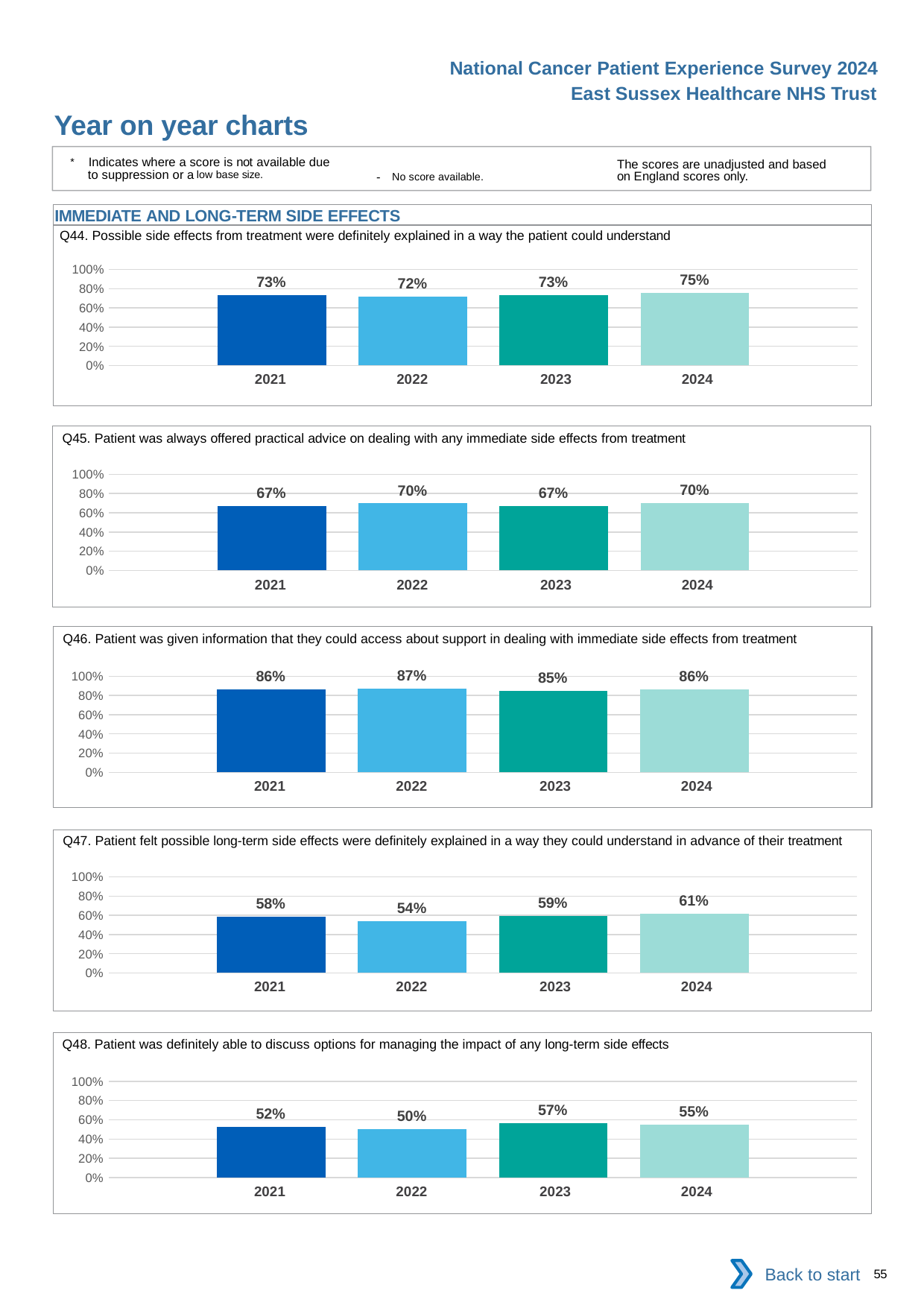
What kind of chart is the Q46 chart? bar chart How many years are shown in the Q44 chart? 4 In the Q45 chart, what is the value for 2021? 67% In the Q48 chart, what is the difference between the 2023 and 2022 values? 7% How many charts are shown on the slide? 5 In the Q46 chart, what is the value for 2023? 85% In the Q44 chart, what is the value for 2024? 75% In the Q47 chart, which is larger, the value for 2021 or the value for 2024? 2024 In the Q46 chart, which year has the highest value? 2022 In the Q47 chart, does the value rise or fall from 2022 to 2024? rise In the Q47 chart, which year has the lowest value? 2022 In the Q48 chart, is the value for 2021 greater or less than 60%? less